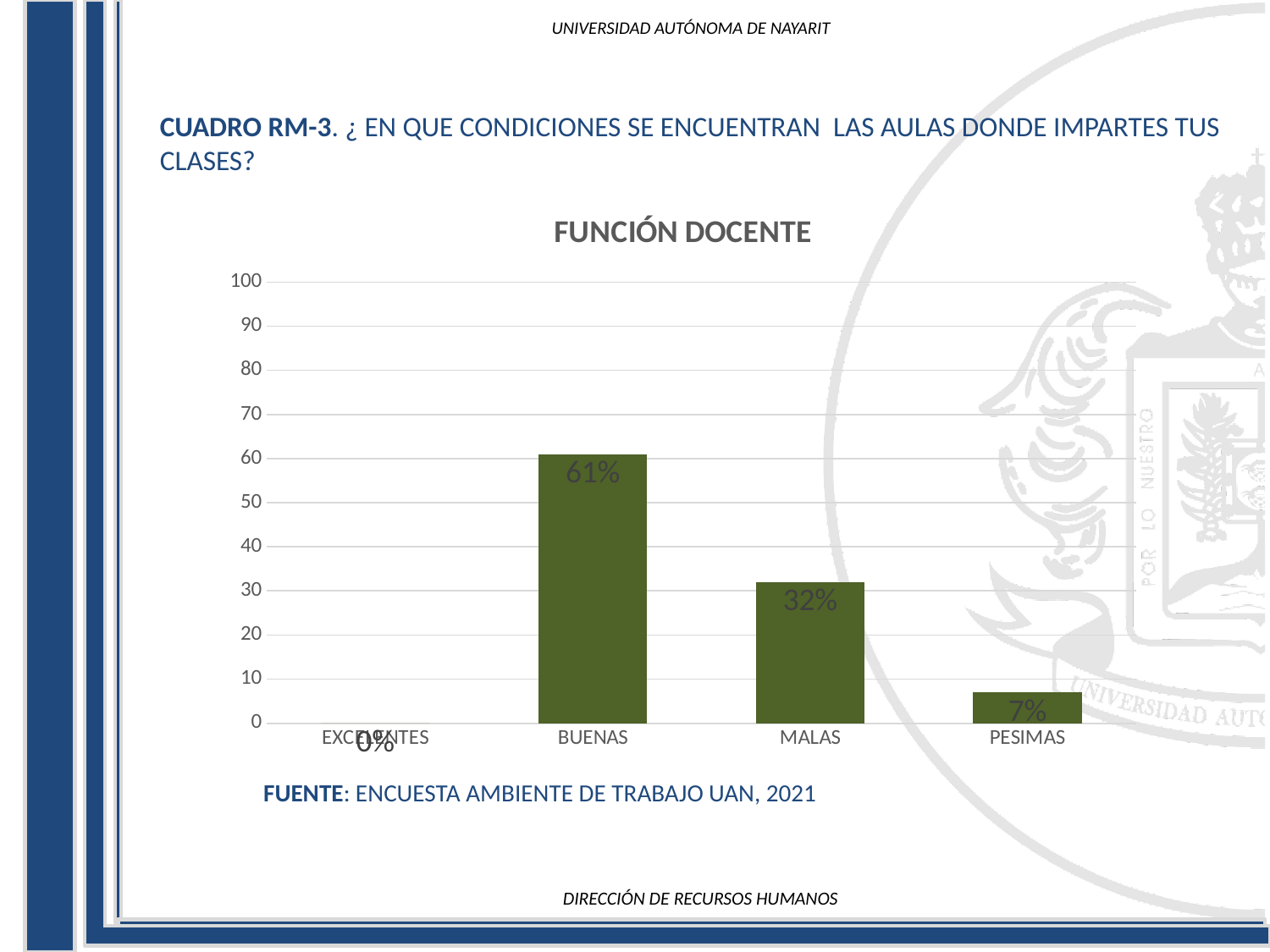
Which category has the highest value? BUENAS Is the value for BUENAS greater or less than 50? greater What kind of chart is shown on the slide? bar chart What is the value for BUENAS? 61% What is the value for EXCELENTES? 0% What is the difference between the values for BUENAS and MALAS? 29% Which category has the lowest value? EXCELENTES What is the value for MALAS? 32% What is the title of the chart? FUNCIÓN DOCENTE How many categories are shown on the x axis? 4 What is the value for PESIMAS? 7% Which is larger, the value for MALAS or the value for PESIMAS? MALAS